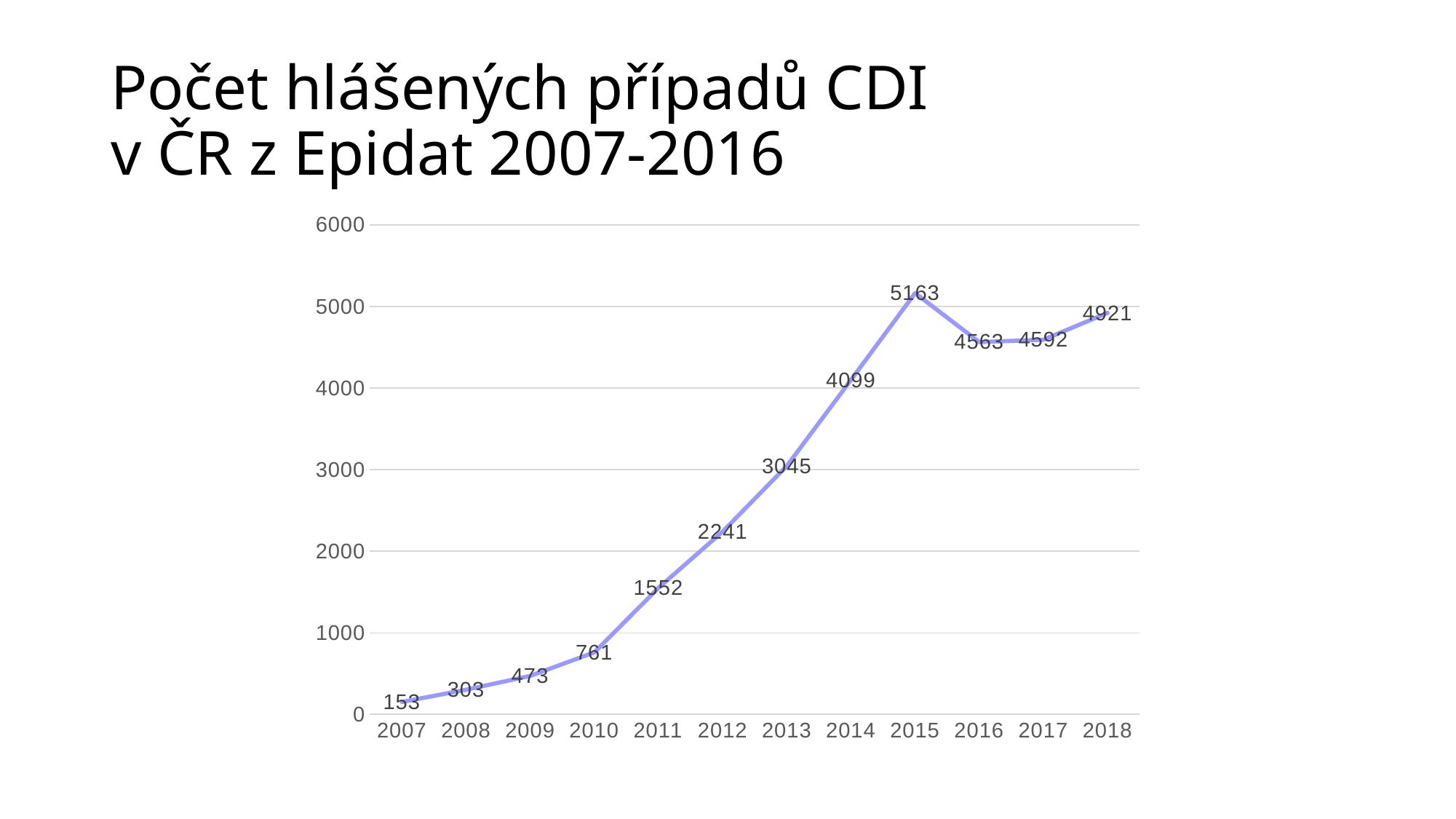
Which year has the highest value? 2015 Which year has the lowest value? 2007 What is the value for 2018? 4921 What is the value for 2007? 153 What is the difference between the values for 2015 and 2016? 600 What type of chart is shown on the slide? line chart Is the value for 2014 greater or less than 4000? greater What is the value for 2013? 3045 How many years are plotted on the x axis? 12 Which is larger, the value for 2017 or the value for 2018? 2018 What is the difference between the values for 2011 and 2010? 791 Do the values rise or fall from 2007 to 2015? rise